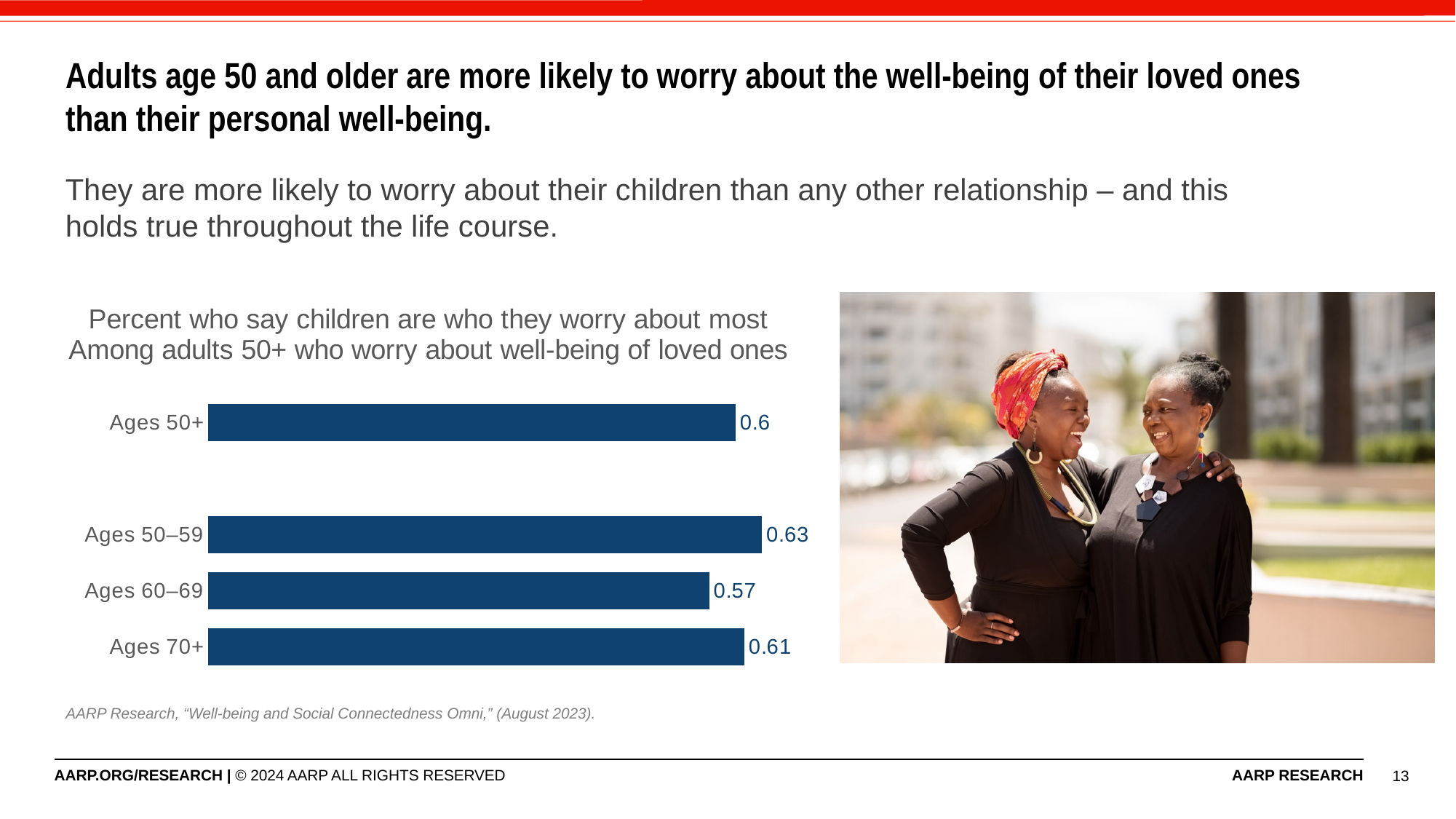
What is the value for Ages 50+? 0.6 How many bars are shown in the chart? 4 What is the value for Ages 60–69? 0.57 Which age group has the lowest value? Ages 60–69 Which is larger, the value for Ages 50–59 or the value for Ages 60–69? Ages 50–59 What is the difference between the values for Ages 70+ and Ages 50+? 0.01 Which age group has the highest value? Ages 50–59 What is the difference between the values for Ages 50–59 and Ages 60–69? 0.06 What is the first line of the chart's title? Percent who say children are who they worry about most What is the value for Ages 50–59? 0.63 What kind of chart is shown on the slide? Bar chart What is the value for Ages 70+? 0.61